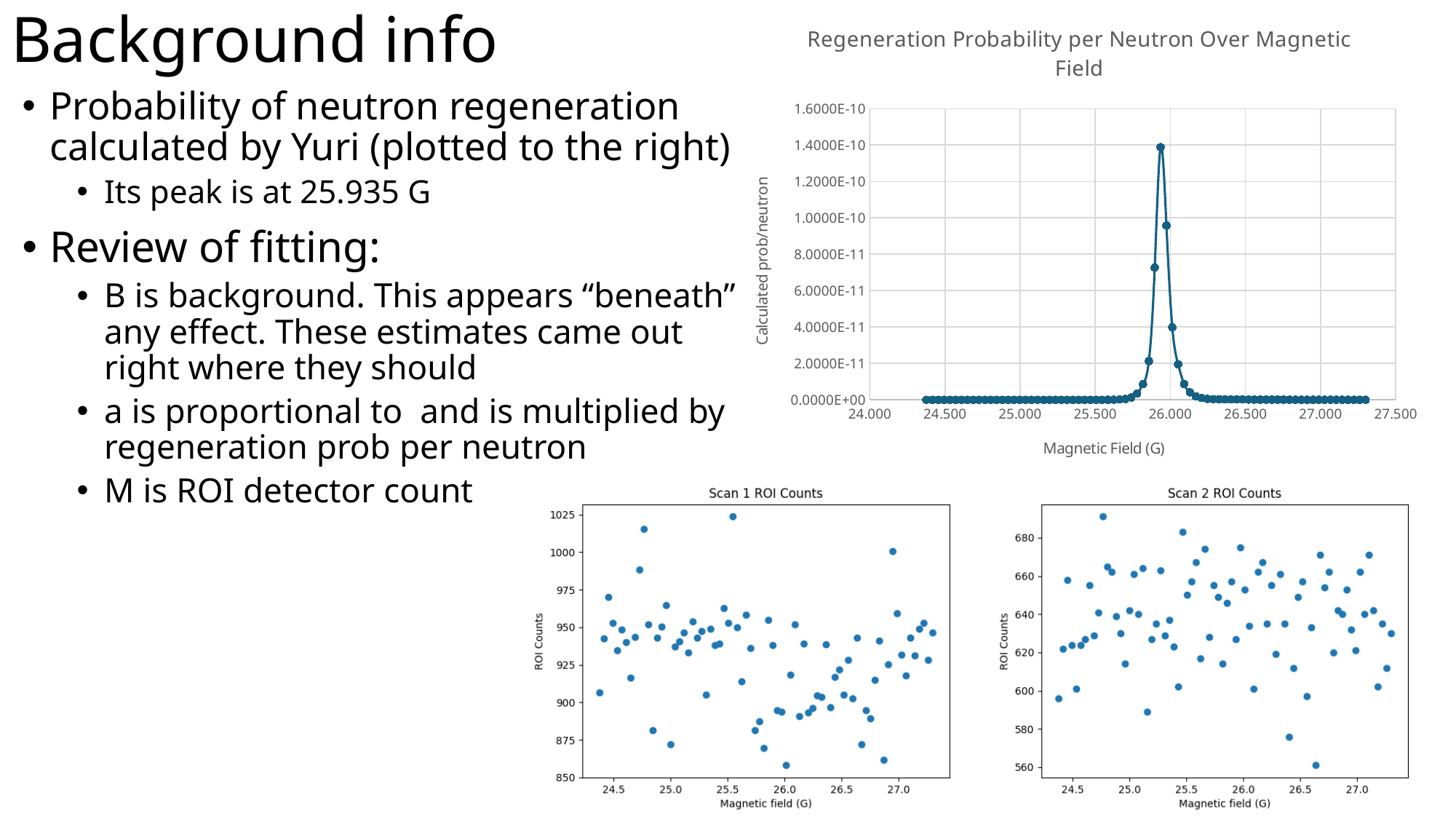
In the 'Regeneration Probability per Neutron Over Magnetic Field' chart, do the values rise or fall as the magnetic field goes from 25.500 to 26.000 G? rise What kind of chart is the 'Scan 1 ROI Counts' chart? scatter chart What is the y-axis label of the 'Regeneration Probability per Neutron Over Magnetic Field' chart? Calculated prob/neutron What is the x-axis label of the 'Scan 2 ROI Counts' chart? Magnetic field (G) In the 'Regeneration Probability per Neutron Over Magnetic Field' chart, is the peak value greater or less than 1.2000E-10? greater What kind of chart is the 'Regeneration Probability per Neutron Over Magnetic Field' chart? line chart In the 'Scan 1 ROI Counts' chart, is the lowest ROI count greater or less than 875? less In the 'Regeneration Probability per Neutron Over Magnetic Field' chart, do the values rise or fall as the magnetic field goes from 26.000 to 26.500 G? fall Is the highest ROI count in the 'Scan 1 ROI Counts' chart greater or less than the highest ROI count in the 'Scan 2 ROI Counts' chart? greater In the 'Scan 2 ROI Counts' chart, is the lowest ROI count greater or less than 580? less